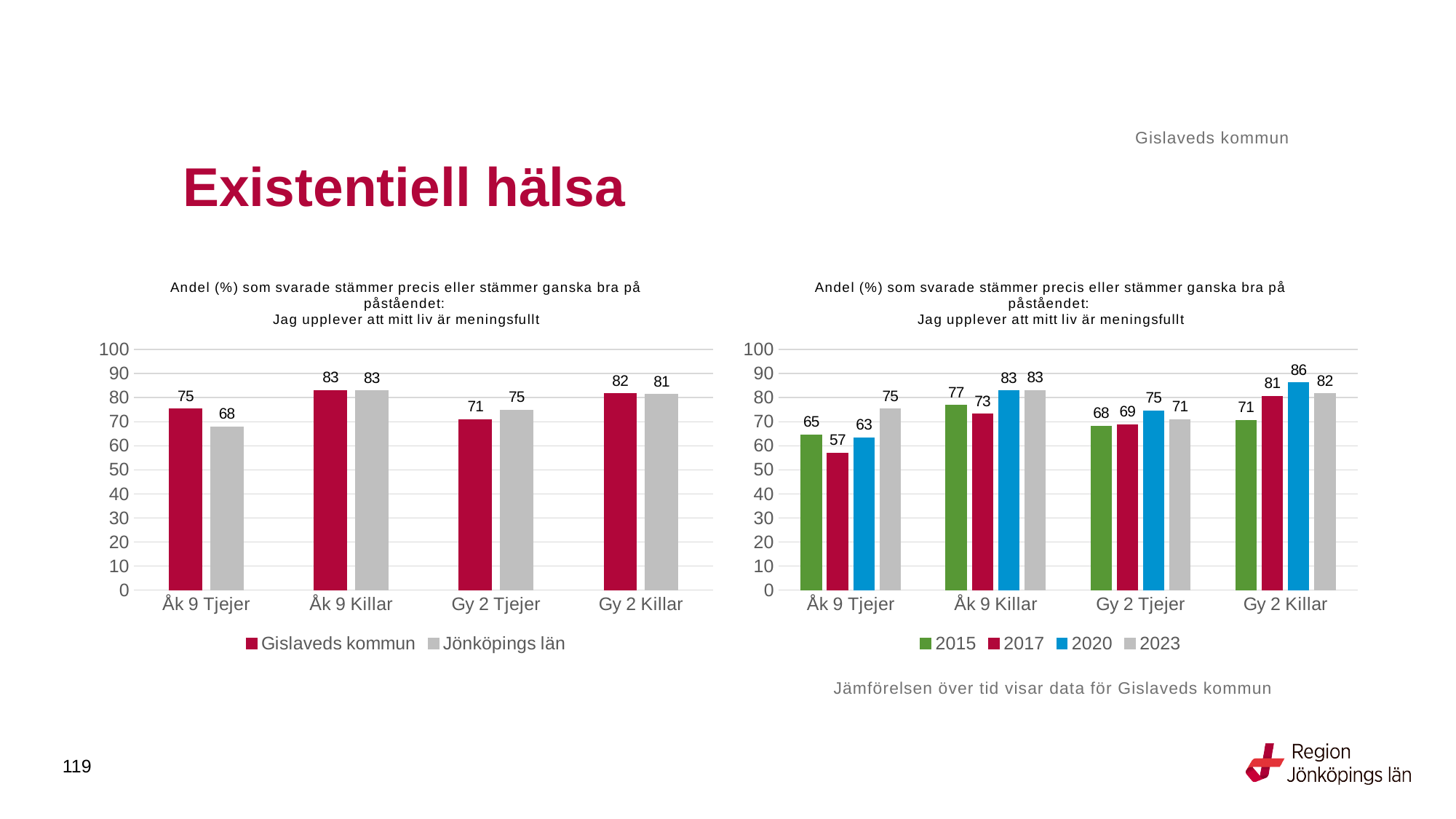
In the left chart, how many series does the legend list? 2 In the right chart, which category has the highest value for 2020? Gy 2 Killar In the left chart, which is larger for Gy 2 Tjejer: Gislaveds kommun or Jönköpings län? Jönköpings län In the right chart, what is the value for 2017 for Åk 9 Tjejer? 57 In the right chart, which category has the lowest value for 2017? Åk 9 Tjejer In the right chart, what is the difference between the 2023 and 2015 values for Åk 9 Tjejer? 10 What kind of chart is the right chart? Bar chart In the left chart, what is the value for Jönköpings län for Gy 2 Tjejer? 75 In the right chart, how many series does the legend list? 4 In the left chart, what is the value for Gislaveds kommun for Åk 9 Tjejer? 75 In the right chart, what is the value for 2020 for Gy 2 Killar? 86 In the left chart, what is the difference between Gislaveds kommun and Jönköpings län for Åk 9 Tjejer? 7